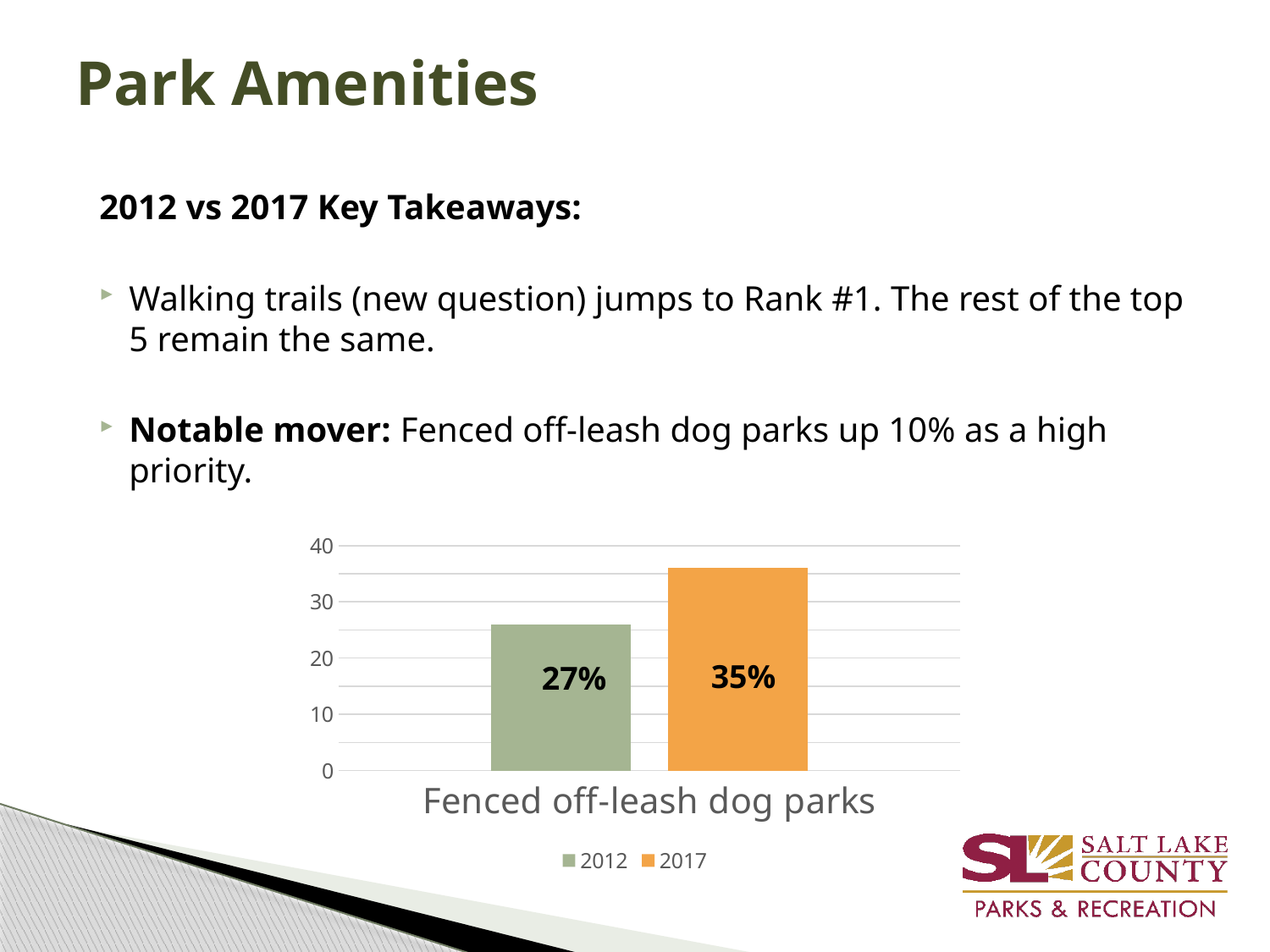
What is the difference between the 2017 and 2012 values for Fenced off-leash dog parks? 8% How many series does the legend list? 2 Which series has the higher value for Fenced off-leash dog parks, 2012 or 2017? 2017 Is the value for 2012 greater or less than 30? less What is the category label shown on the x axis of the chart? Fenced off-leash dog parks What is the highest value shown on the y axis of the chart? 40 What is the value for 2017 for Fenced off-leash dog parks? 35% How many categories are shown on the x axis? 1 Which series is shown in orange in the chart? 2017 Is the value for 2017 greater or less than 30? greater What kind of chart is shown on the slide? bar chart What is the value for 2012 for Fenced off-leash dog parks? 27%